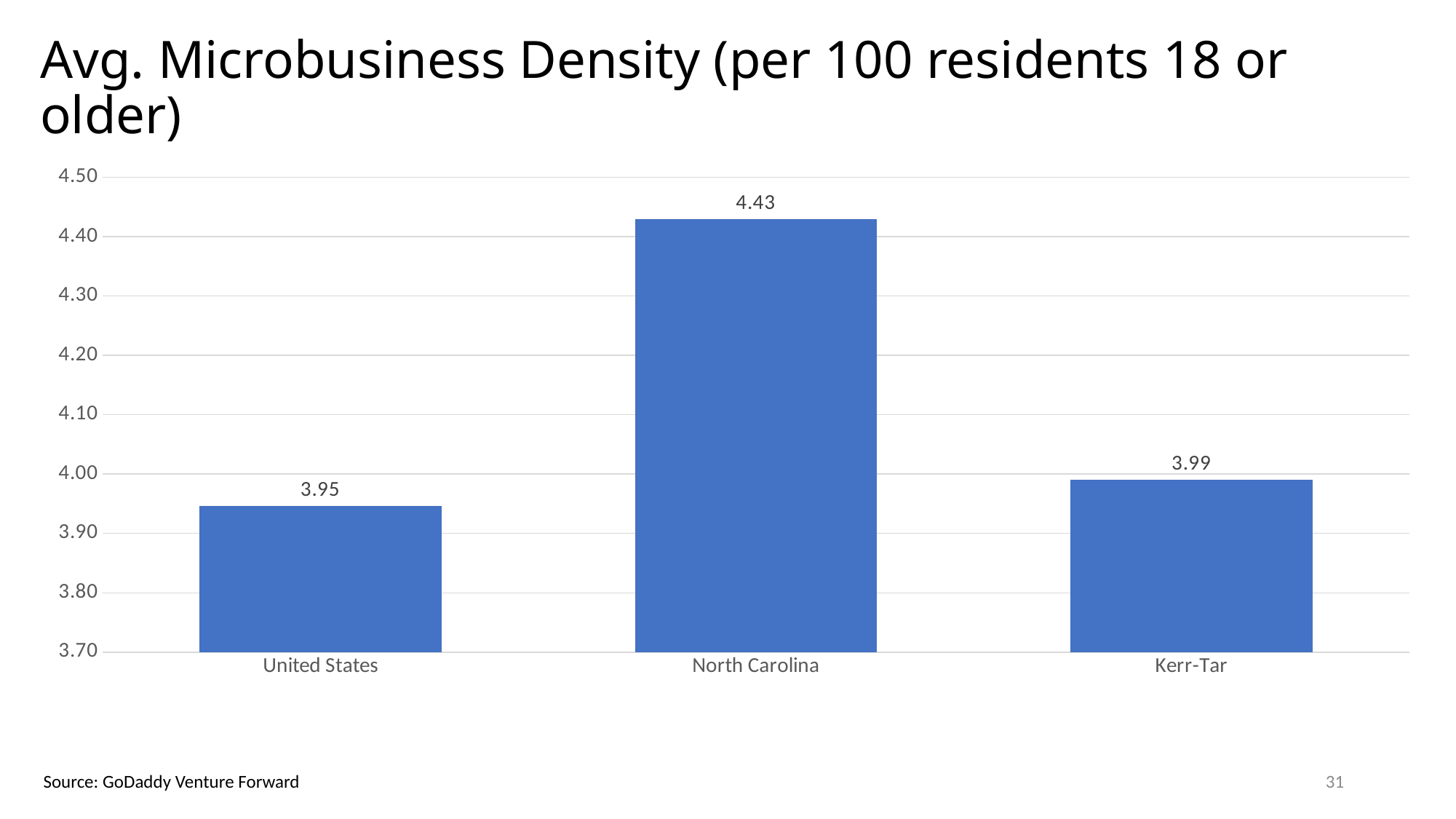
What is the average microbusiness density for the United States? 3.95 Which category has the highest average microbusiness density? North Carolina Is the value for North Carolina greater or less than 4.20? greater What is the source cited for the chart? GoDaddy Venture Forward What is the difference between the North Carolina and United States values? 0.48 What kind of chart is shown on the slide? Bar chart What is the average microbusiness density for Kerr-Tar? 3.99 Which is larger, the value for Kerr-Tar or the value for United States? Kerr-Tar What is the difference between the North Carolina and Kerr-Tar values? 0.44 How many categories are shown on the x axis? 3 What is the average microbusiness density for North Carolina? 4.43 Which category has the lowest average microbusiness density? United States